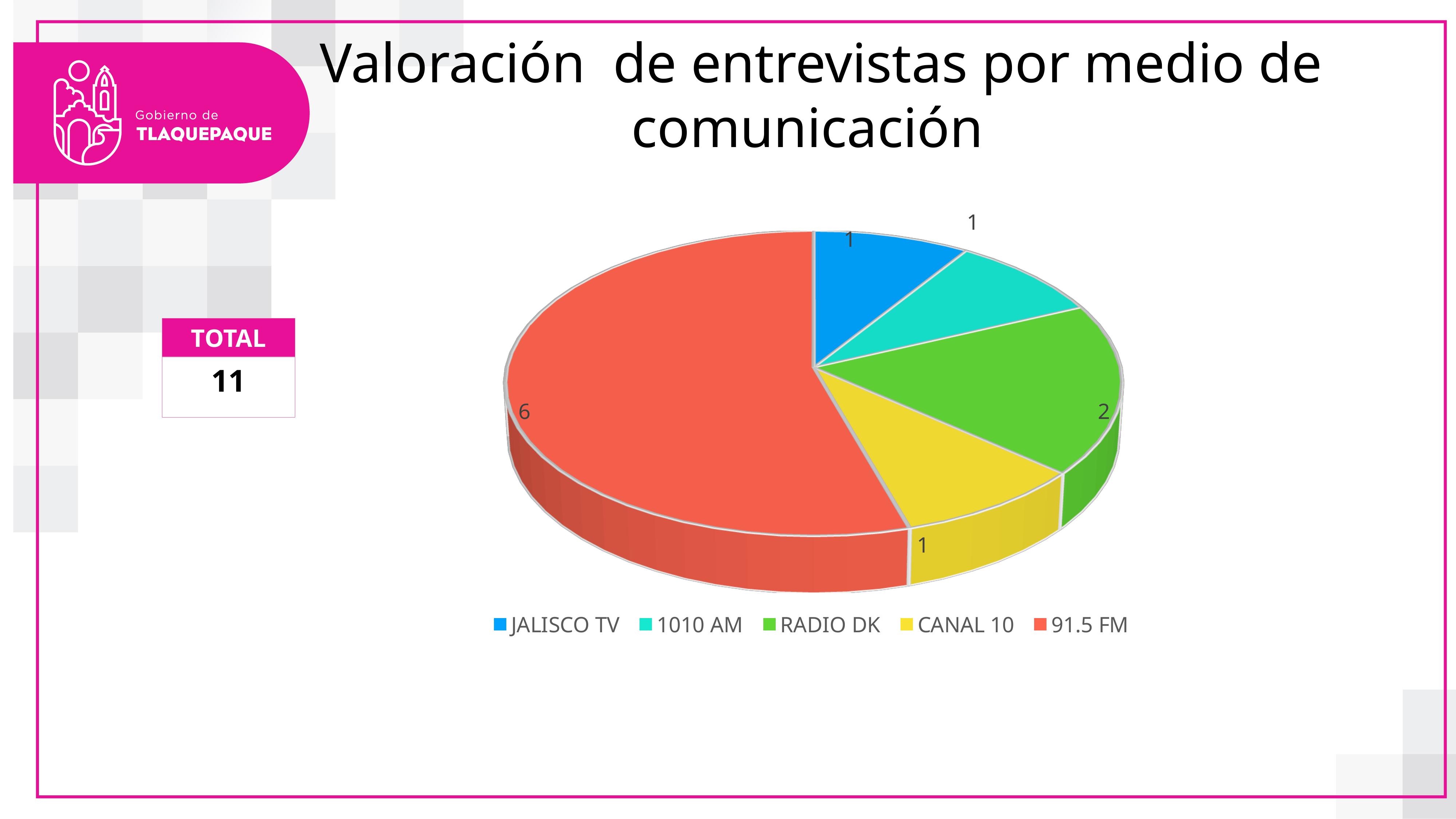
Which is larger, the value for RADIO DK or the value for 1010 AM? RADIO DK What type of chart is shown on the slide? pie chart What is the value for JALISCO TV? 1 Which medium has the largest slice of the pie? 91.5 FM How many slices does the pie chart have? 5 What is the total of all the slices in the pie chart? 11 What fraction of the total does the 91.5 FM slice represent? 6/11 What is the value for CANAL 10? 1 What is the difference between the values for 91.5 FM and RADIO DK? 4 What is the value for RADIO DK? 2 What is the value for 91.5 FM? 6 What colour is the slice for CANAL 10? yellow